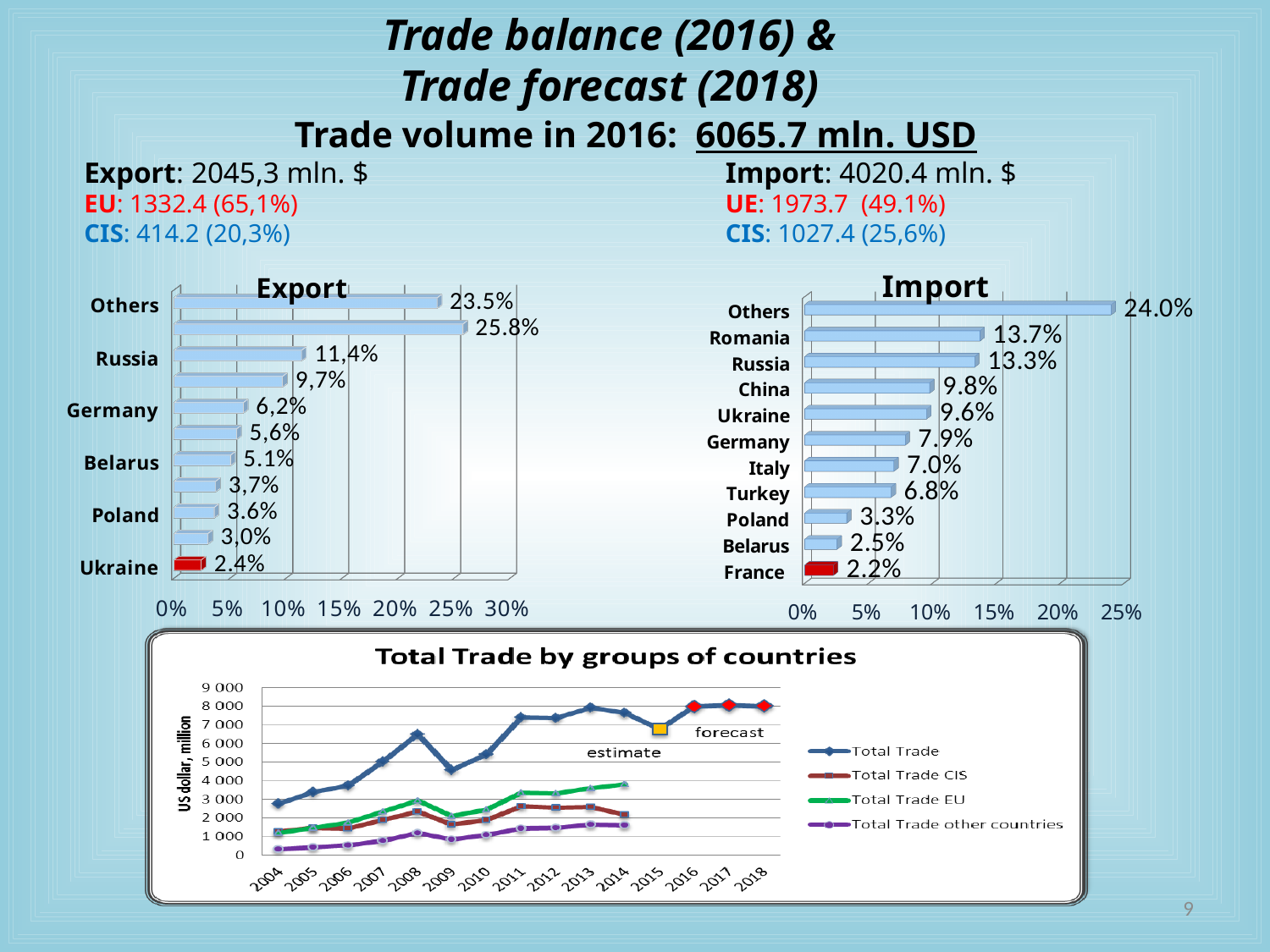
In the Export chart, what is the value for Ukraine? 2.4% How many series does the legend of the 'Total Trade by groups of countries' chart list? 4 In the Export chart, what is the value for Russia? 11,4% In the 'Total Trade by groups of countries' chart, is the Total Trade value for 2009 greater or less than 5 000? less What kind of chart is 'Total Trade by groups of countries'? line chart In the Import chart, which category has the lowest value? France In the Import chart, which category has the highest value? Others In the Import chart, what is the difference between the values for Russia and China? 3.5% In the 'Total Trade by groups of countries' chart, does the Total Trade series rise or fall from 2004 to 2008? rise How many categories are shown in the Import chart? 11 In the Import chart, what is the value for Romania? 13.7% In the Export chart, which is larger, the value for Germany or the value for Belarus? Germany